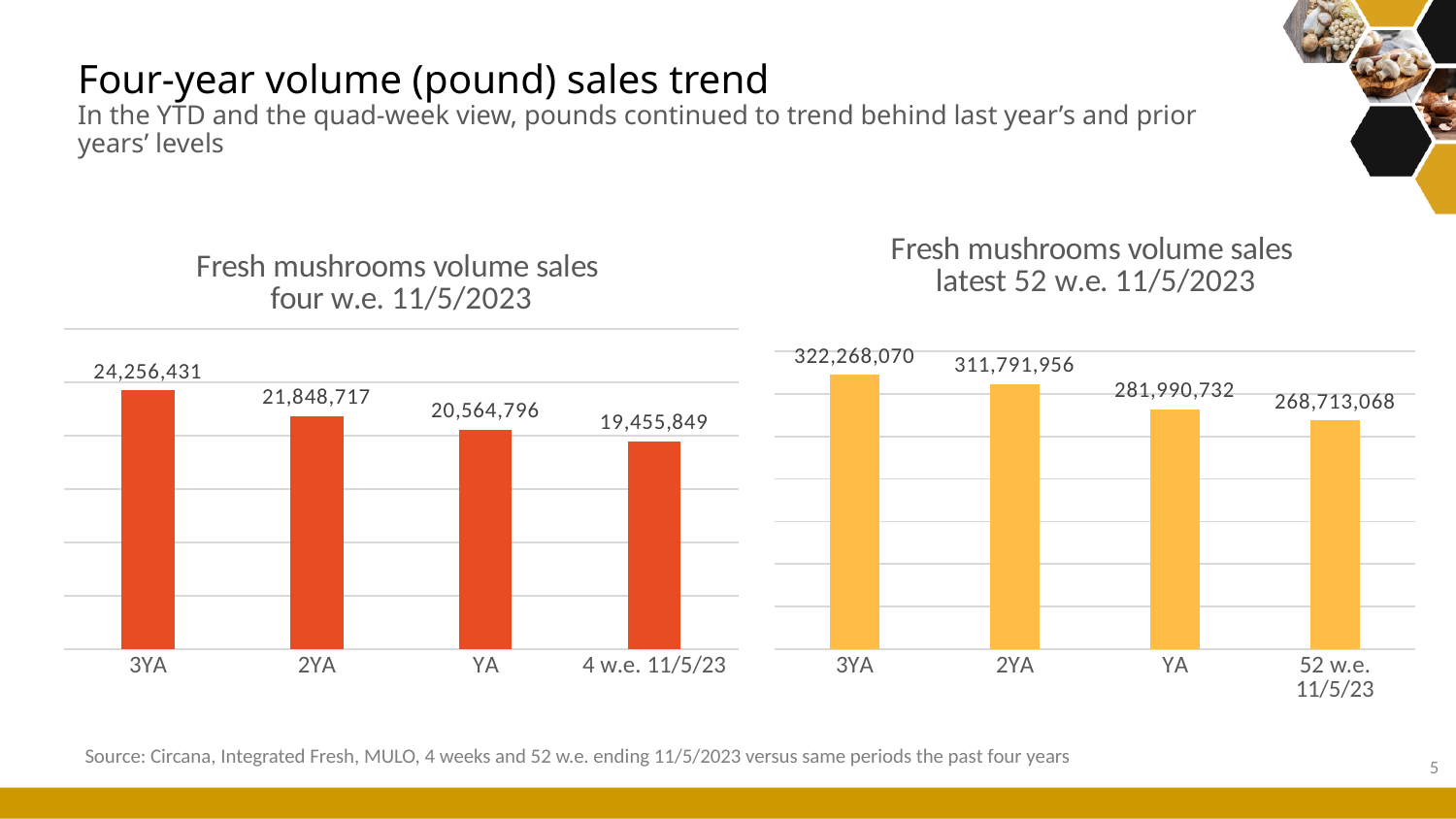
In the 'Fresh mushrooms volume sales latest 52 w.e. 11/5/2023' chart, do the values rise or fall from 3YA to 52 w.e. 11/5/23? Fall In the 'Fresh mushrooms volume sales latest 52 w.e. 11/5/2023' chart, which category has the lowest value? 52 w.e. 11/5/23 In the 'Fresh mushrooms volume sales four w.e. 11/5/2023' chart, what is the value for 4 w.e. 11/5/23? 19,455,849 What kind of chart is the 'Fresh mushrooms volume sales four w.e. 11/5/2023' chart? Bar chart In the 'Fresh mushrooms volume sales latest 52 w.e. 11/5/2023' chart, what is the value for YA? 281,990,732 In the 'Fresh mushrooms volume sales four w.e. 11/5/2023' chart, which category has the highest value? 3YA In the 'Fresh mushrooms volume sales latest 52 w.e. 11/5/2023' chart, what is the value for 52 w.e. 11/5/23? 268,713,068 In the 'Fresh mushrooms volume sales latest 52 w.e. 11/5/2023' chart, what is the difference between the YA value and the 52 w.e. 11/5/23 value? 13,277,664 How many categories are shown in the 'Fresh mushrooms volume sales latest 52 w.e. 11/5/2023' chart? 4 In the 'Fresh mushrooms volume sales four w.e. 11/5/2023' chart, what is the value for 3YA? 24,256,431 In the 'Fresh mushrooms volume sales four w.e. 11/5/2023' chart, which is larger, the value for 2YA or the value for YA? 2YA In the 'Fresh mushrooms volume sales four w.e. 11/5/2023' chart, what is the difference between the 3YA value and the 4 w.e. 11/5/23 value? 4,800,582